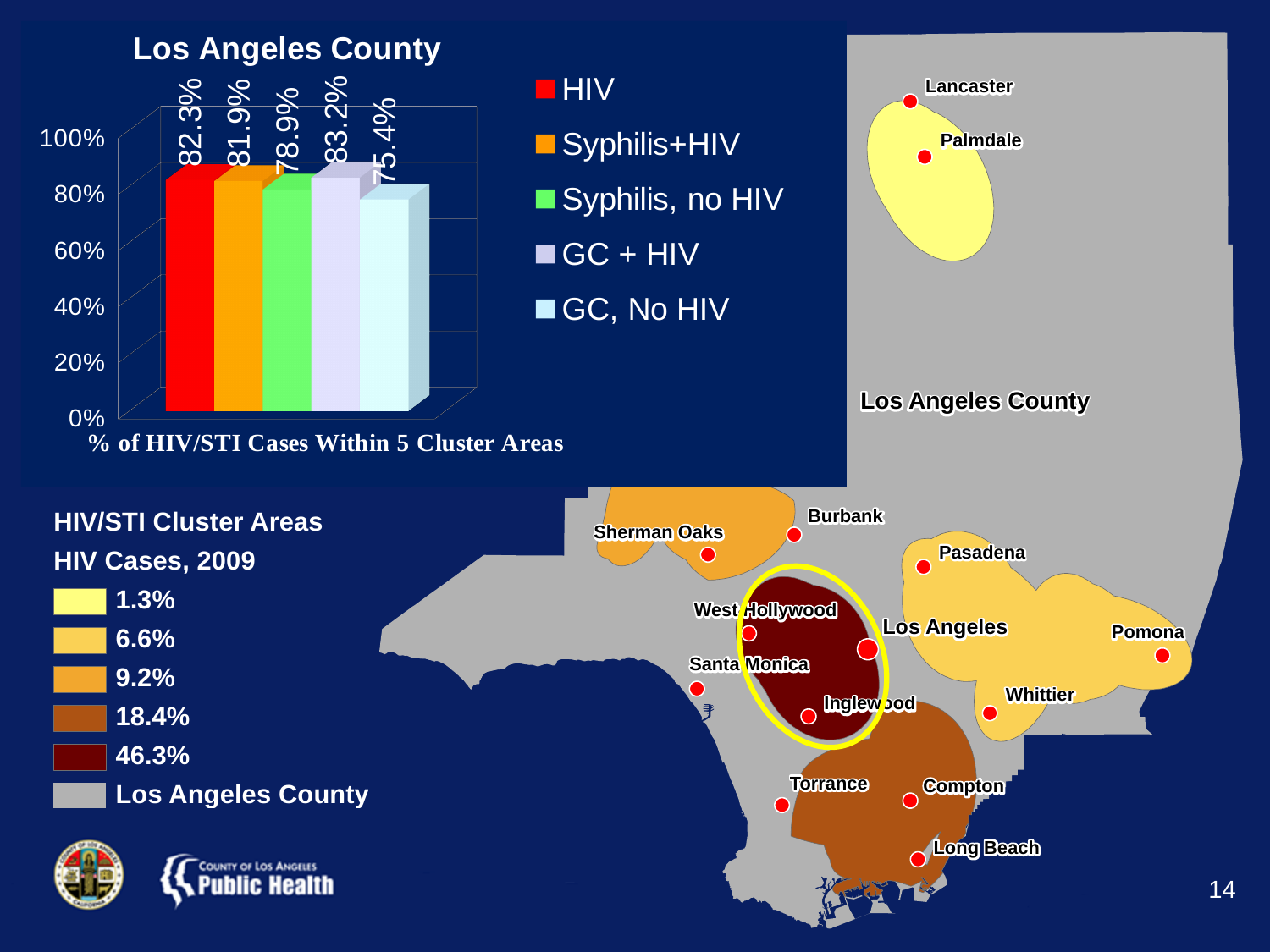
How many series does the legend of the bar chart list? 5 What is the value for GC + HIV in the bar chart? 83.2% Which series has the lowest value in the bar chart? GC, No HIV Which series has the highest value in the bar chart? GC + HIV What kind of chart is shown in the top-left of the slide? Bar chart What is the value for Syphilis, no HIV in the bar chart? 78.9% What is the value for Syphilis+HIV in the bar chart? 81.9% What is the title of the bar chart? Los Angeles County What is the value for GC, No HIV in the bar chart? 75.4% What is the difference between the GC + HIV value and the GC, No HIV value in the bar chart? 7.8% Which is larger in the bar chart, the value for HIV or the value for Syphilis, no HIV? HIV What is the value for HIV in the bar chart? 82.3%